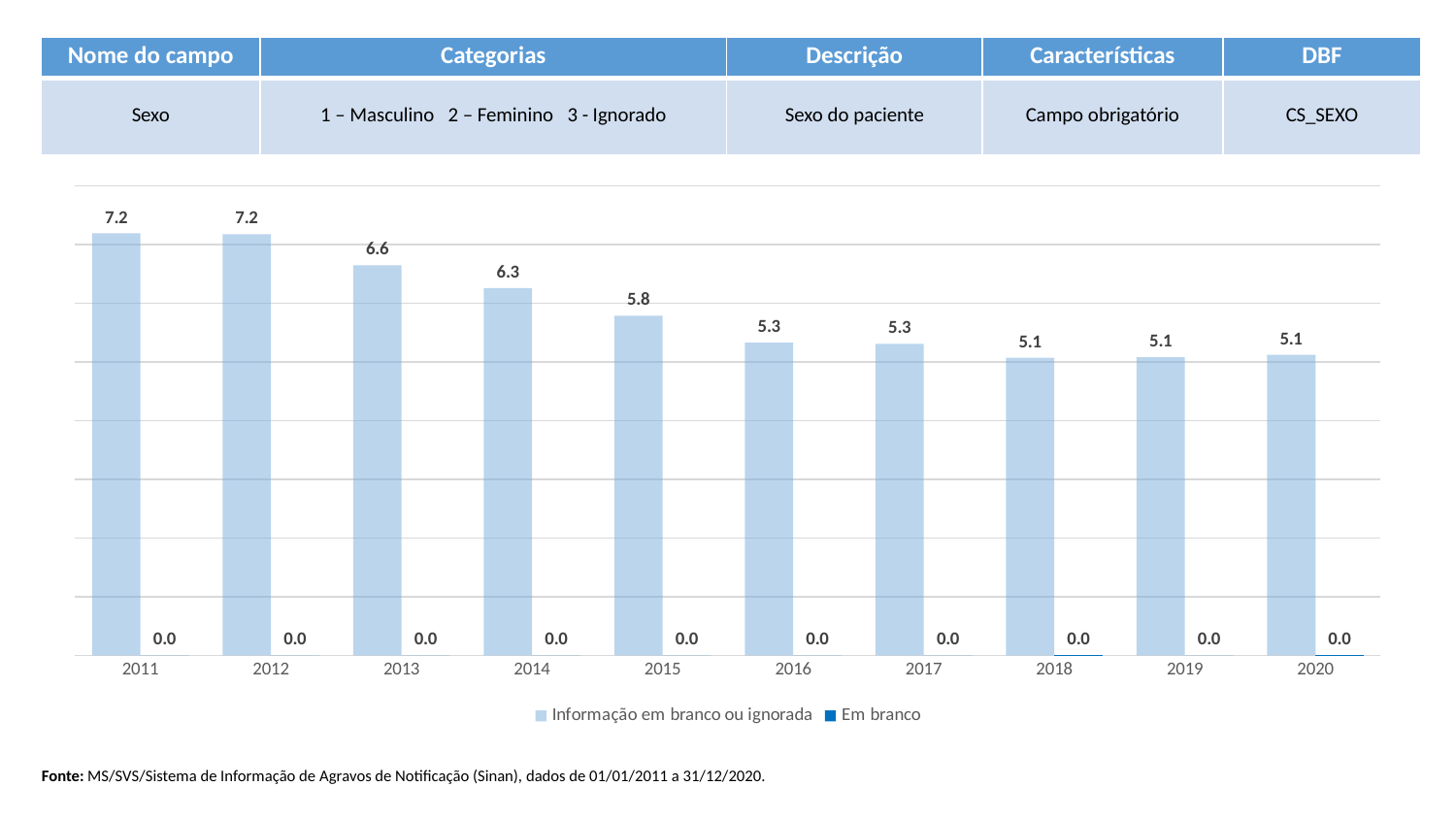
What is the value for "Informação em branco ou ignorada" in 2015? 5.8 Which year has the lowest value for "Informação em branco ou ignorada" among 2011 to 2017? 2016 and 2017 (5.3) What is the value for "Informação em branco ou ignorada" in 2020? 5.1 How many years are shown on the x axis of the chart? 10 Which is larger, the "Informação em branco ou ignorada" value for 2012 or for 2016? 2012 What is the value for "Em branco" in 2014? 0.0 Does the "Informação em branco ou ignorada" series rise or fall from 2011 to 2020? Fall What is the difference between the "Informação em branco ou ignorada" values for 2011 and 2020? 2.1 What is the difference between the "Informação em branco ou ignorada" values for 2013 and 2014? 0.3 What is the value for "Informação em branco ou ignorada" in 2011? 7.2 What kind of chart is shown on the slide? Bar chart How many series does the chart legend list? 2